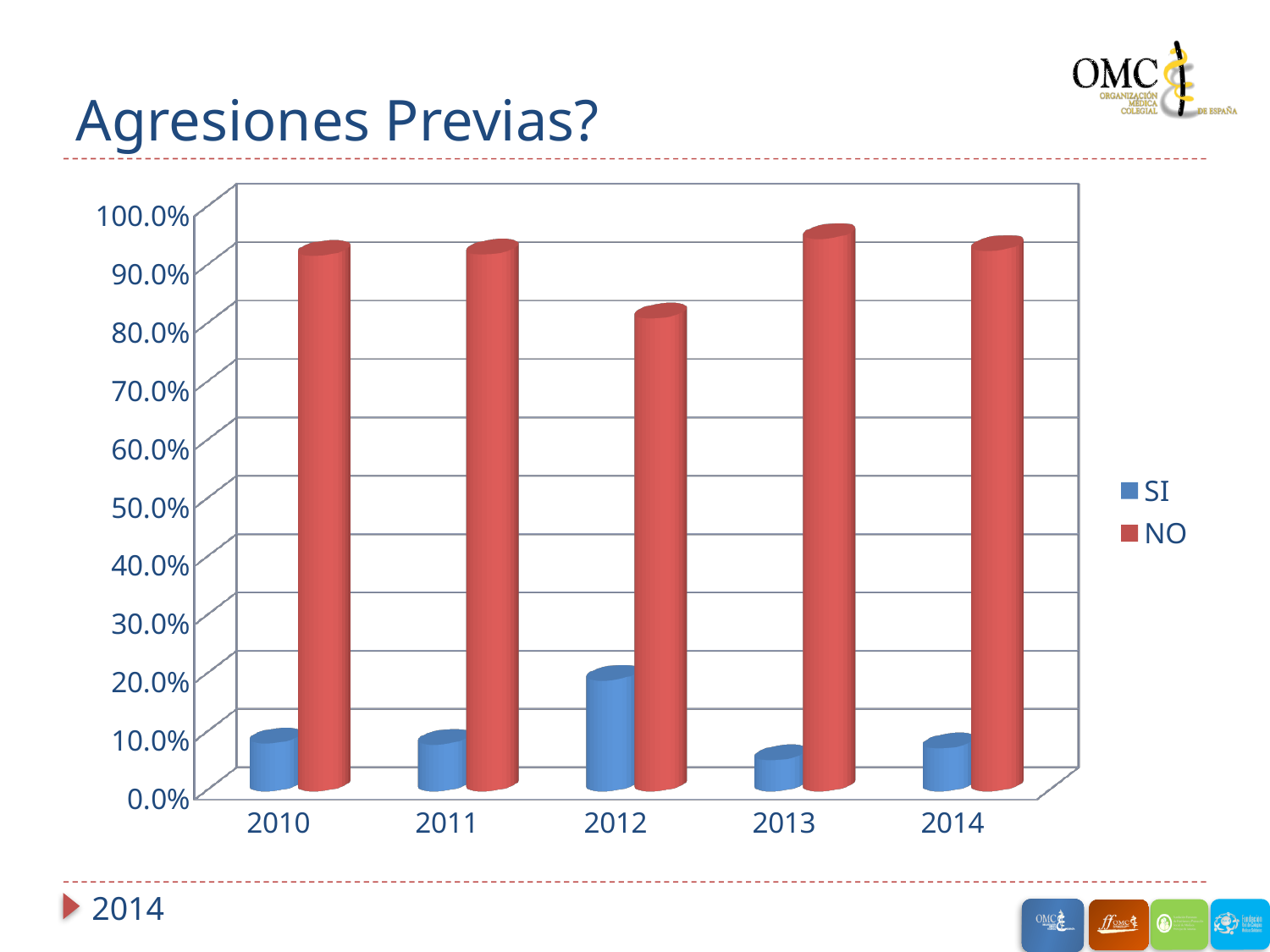
Is the value for SI in 2012 greater or less than 10.0%? greater What colour are the bars for the NO series? red Which year has the highest value for SI? 2012 Which year has the lowest value for SI? 2013 Which is larger, the SI value for 2012 or the SI value for 2010? 2012 Which year has the lowest value for NO? 2012 How many years are shown on the x axis? 5 Is the value for SI in 2013 greater or less than 10.0%? less Is the value for NO in 2012 greater or less than 90.0%? less What kind of chart is shown on the slide? bar chart How many series does the legend list? 2